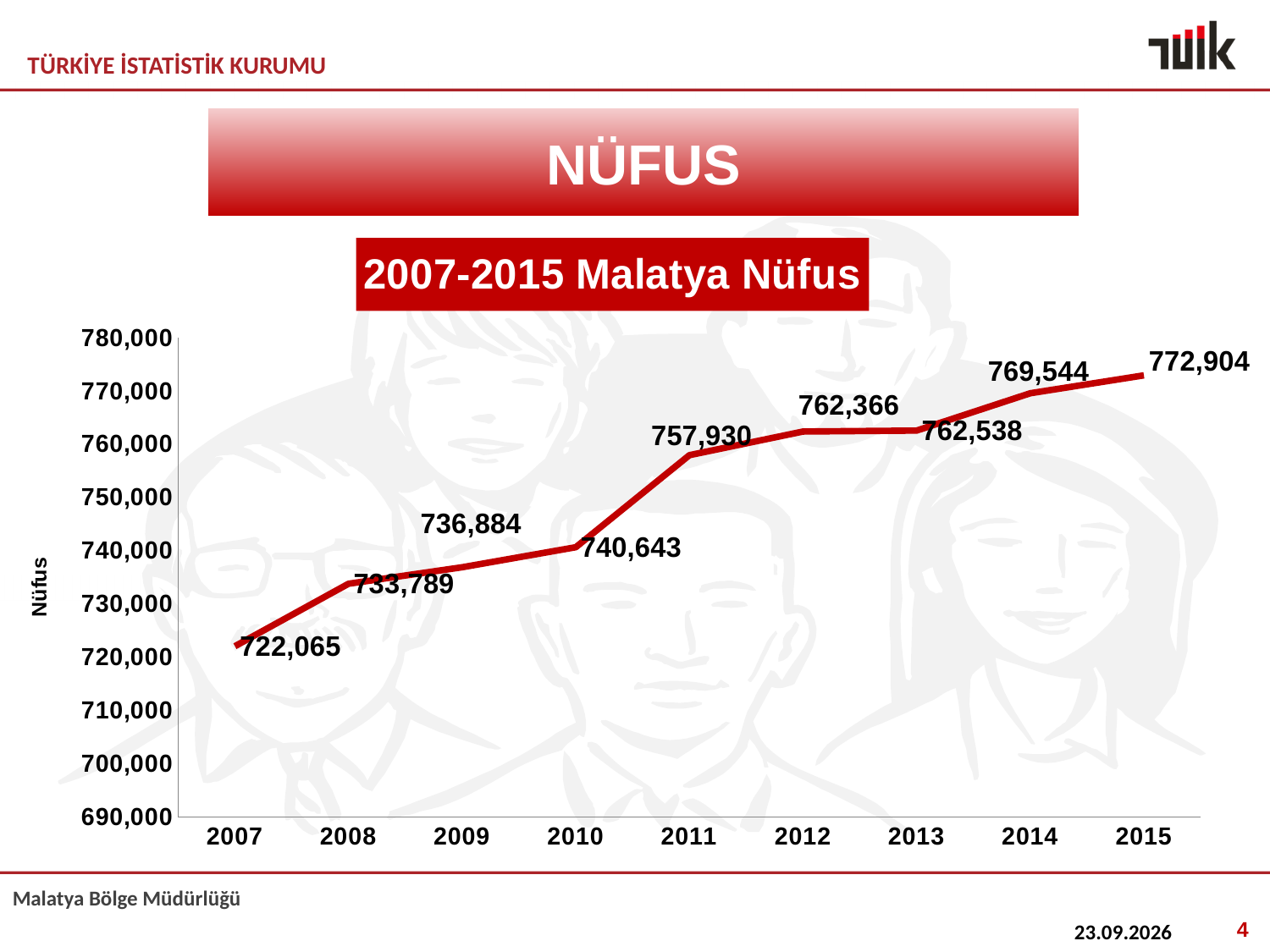
By how much did the population increase from 2007 to 2015? 50,839 Does the population rise or fall from 2007 to 2015? Rise What is the difference between the population in 2011 and in 2010? 17,287 Which year has the lowest population value on the chart? 2007 What was the population of Malatya in 2015? 772,904 What type of chart is shown on the slide? Line chart How many years are plotted on the chart? 9 Is the population value for 2009 greater or less than 730,000? greater What was the population of Malatya in 2011? 757,930 What was the population of Malatya in 2007? 722,065 Which year has the highest population value on the chart? 2015 Which year had a larger population, 2009 or 2014? 2014